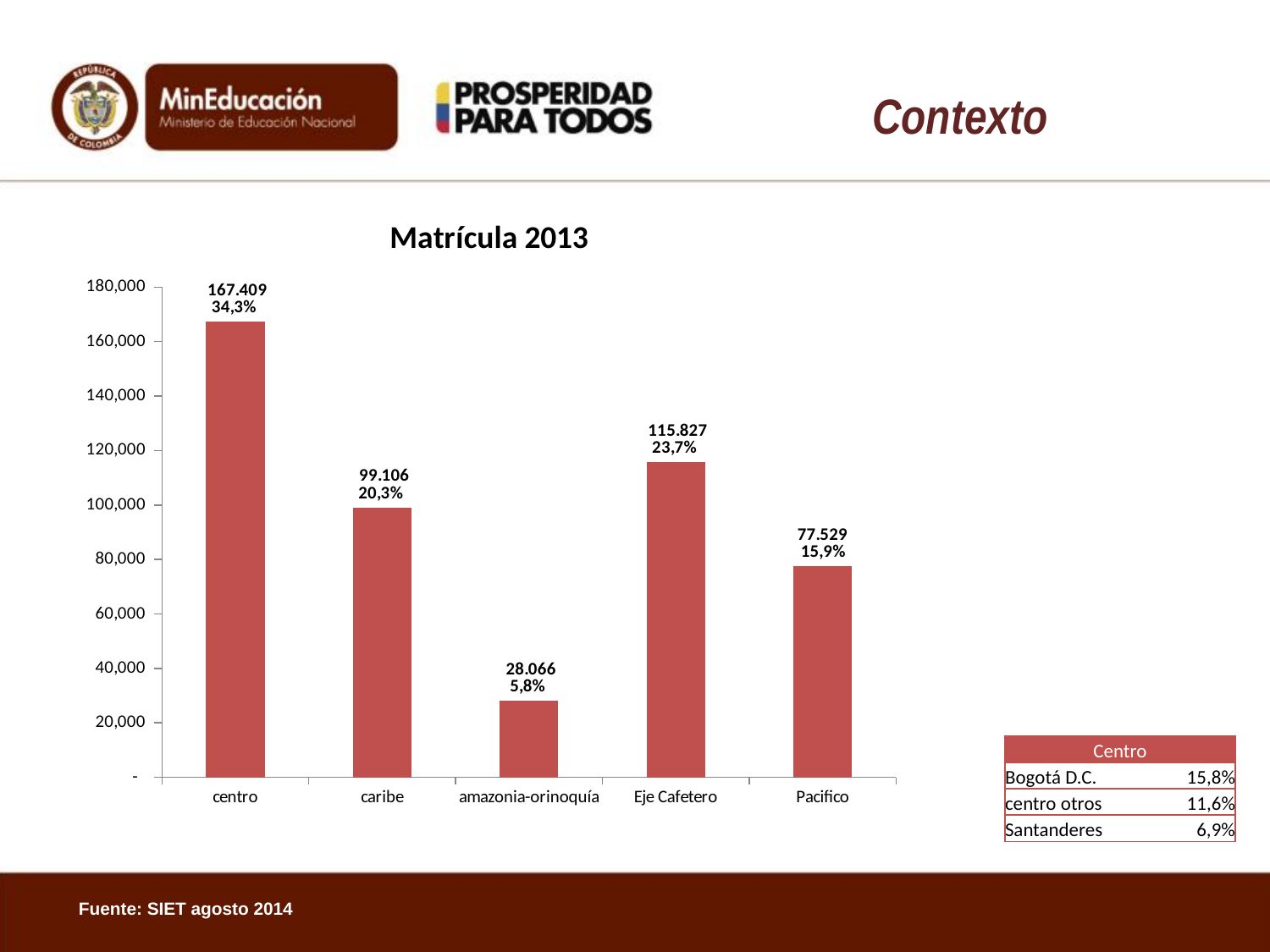
What is the value shown for centro? 167.409 Which category has the lowest value? amazonia-orinoquía What percentage is shown for Eje Cafetero? 23,7% Which is larger, the value for Eje Cafetero or the value for Pacifico? Eje Cafetero Which category has the highest value? centro What type of chart is shown on the slide? bar chart What percentage is shown for caribe? 20,3% Is the value for Pacifico greater or less than 80,000? less How many categories are plotted in the chart? 5 What is the difference between the values for centro and caribe? 68.303 What is the title of the chart? Matrícula 2013 What is the value shown for amazonia-orinoquía? 28.066